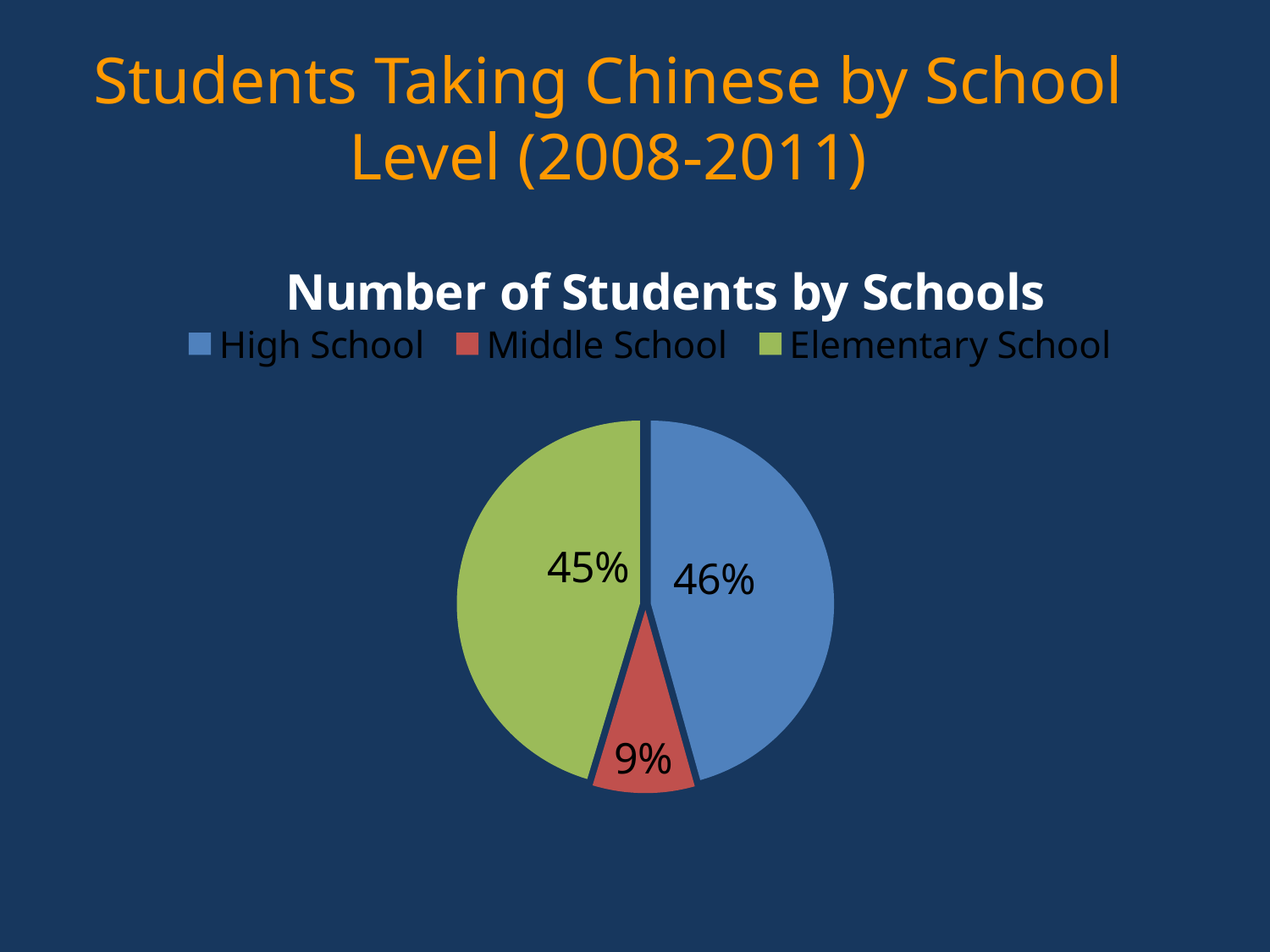
How many categories does the pie chart show? 3 Which school level has the largest slice of the pie? High School What share of the pie does Middle School represent? 9% What colour is the Middle School slice? red What share of the pie does High School represent? 46% What type of chart is shown on the slide? pie chart Which school level has the smallest slice of the pie? Middle School How many entries does the legend list? 3 What share of the pie does Elementary School represent? 45% Which is larger, the Elementary School slice or the Middle School slice? Elementary School What is the difference in percentage points between the High School and Middle School slices? 37% What is the title of the chart? Number of Students by Schools